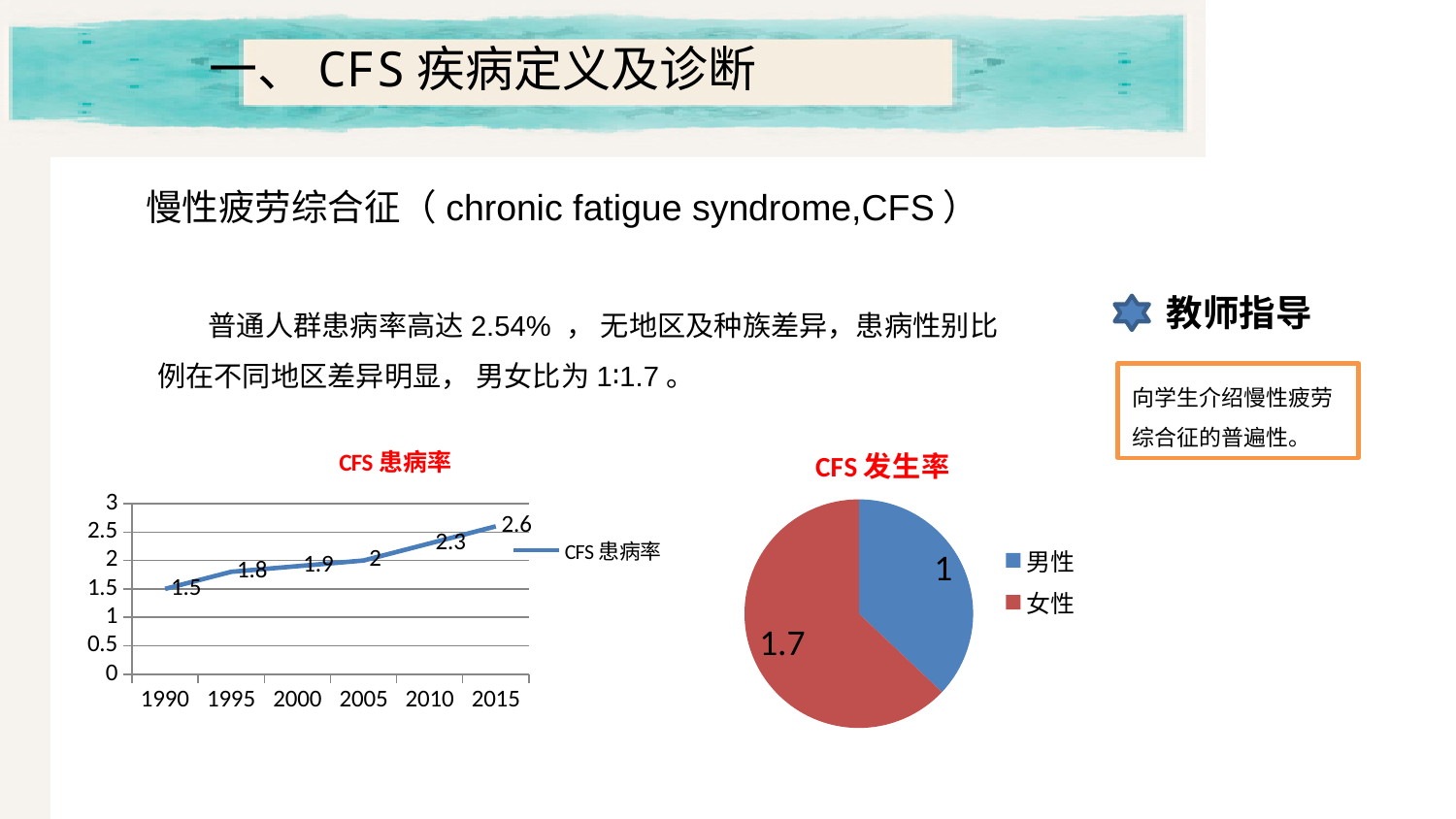
In the "CFS 发生率" chart, which category is larger, 男性 or 女性? 女性 How many data points are plotted in the "CFS 患病率" chart? 6 In the "CFS 患病率" chart, what is the value for 1990? 1.5 What kind of chart is the "CFS 发生率" chart? pie chart What kind of chart is the "CFS 患病率" chart? line chart In the "CFS 患病率" chart, which year has the lowest value? 1990 In the "CFS 患病率" chart, which year has the highest value? 2015 In the "CFS 患病率" chart, what is the value for 2005? 2 In the "CFS 患病率" chart, what is the value for 2015? 2.6 In the "CFS 发生率" chart, what is the value for 女性? 1.7 In the "CFS 患病率" chart, what is the difference between the values for 2015 and 1990? 1.1 In the "CFS 患病率" chart, do the values rise or fall from 1990 to 2015? rise